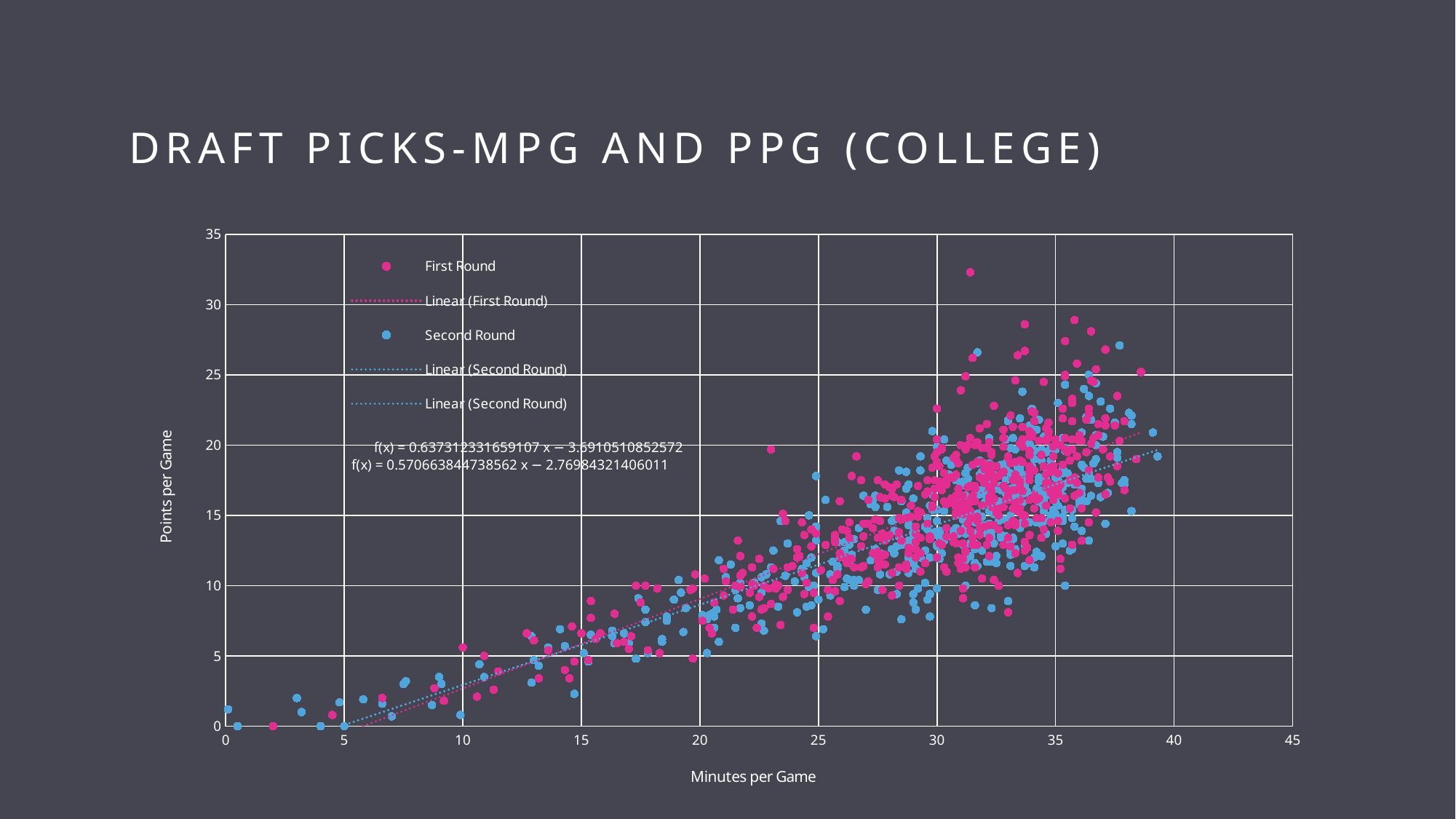
What is the label of the x axis? Minutes per Game What is the maximum value shown on the y axis? 35 Is the highest plotted points-per-game value greater or less than 30? greater Do points per game generally rise or fall as minutes per game increase? Rise What is the trendline equation printed first (top) on the chart? f(x) = 0.637312331659107 x − 3.5910510852572 What kind of chart is shown on the slide? Scatter chart What is the title of the chart? DRAFT PICKS-MPG AND PPG (COLLEGE) What is the trendline equation printed second (bottom) on the chart? f(x) = 0.570663844738562 x − 2.76984321406011 What is the maximum value shown on the x axis? 45 Is the largest minutes-per-game value plotted greater or less than 40? less Which series does the highest plotted point (above 30 points per game) belong to? First Round How many entries does the legend list? 5